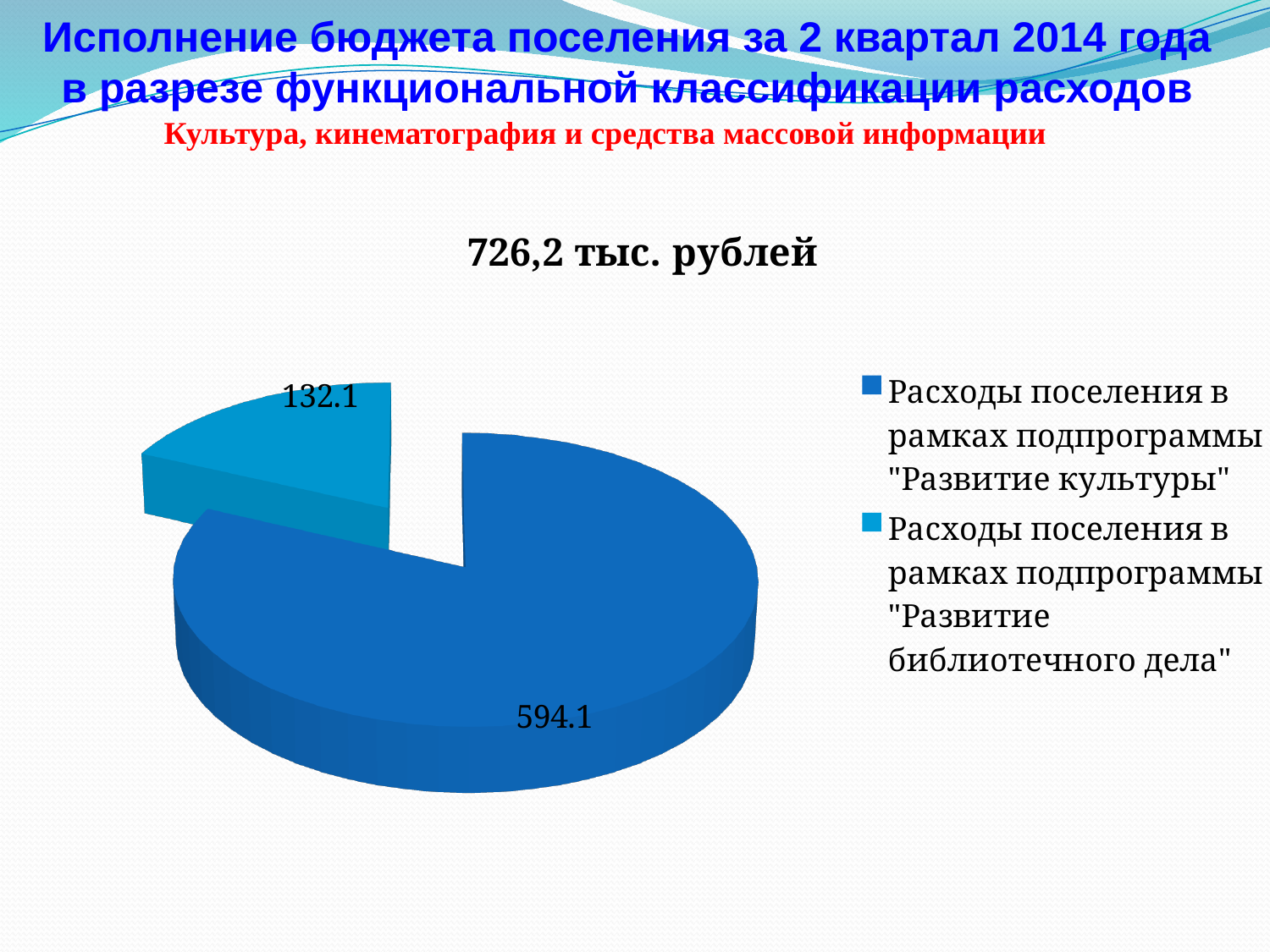
What colour is the slice for 'Развитие библиотечного дела'? light blue What is the value of the slice for 'Расходы поселения в рамках подпрограммы "Развитие библиотечного дела"'? 132.1 What is the total of the two slices shown in the pie chart? 726.2 Which category has the smallest slice of the pie? Расходы поселения в рамках подпрограммы "Развитие библиотечного дела" What is the difference between the 'Развитие культуры' slice and the 'Развитие библиотечного дела' slice? 462.0 How many slices does the pie chart have? 2 Which is larger: the 'Развитие культуры' slice or the 'Развитие библиотечного дела' slice? Развитие культуры What is the title shown above the pie chart? 726,2 тыс. рублей How many entries does the legend list? 2 What is the value of the slice for 'Расходы поселения в рамках подпрограммы "Развитие культуры"'? 594.1 What type of chart is shown on the slide? pie chart Which category has the largest slice of the pie? Расходы поселения в рамках подпрограммы "Развитие культуры"